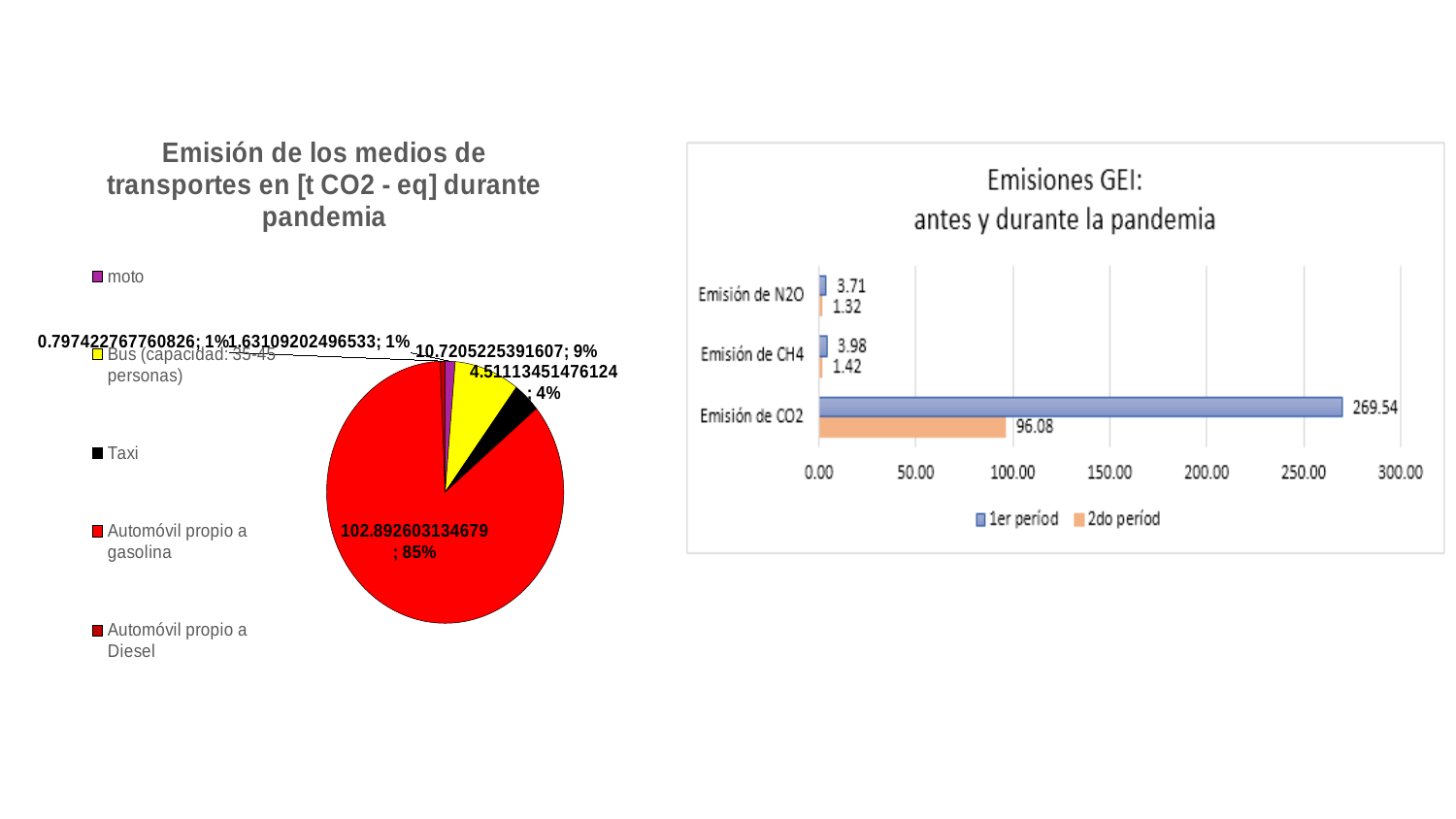
In the 'Emisiones GEI' chart, which category has the highest value for '1er período'? Emisión de CO2 In the 'Emisiones GEI' chart, what is the difference between the '1er período' and '2do período' values for 'Emisión de CO2'? 173.46 In the 'Emisiones GEI' chart, what is the value of 'Emisión de N2O' for '2do período'? 1.32 In the 'Emisiones GEI' chart, how many categories are shown on the vertical axis? 3 In the 'Emisiones GEI' chart, what is the value of 'Emisión de CH4' for '1er período'? 3.98 In the pie chart 'Emisión de los medios de transportes en [t CO2 - eq] durante pandemia', what is the value shown for 'Bus (capacidad: 35-45 personas)'? 10.7205225391607 In the 'Emisiones GEI' chart, what is the value of 'Emisión de CO2' for '2do período'? 96.08 In the pie chart 'Emisión de los medios de transportes en [t CO2 - eq] durante pandemia', how many entries does the legend list? 5 What kind of chart is the chart titled 'Emisiones GEI: antes y durante la pandemia'? bar chart In the 'Emisiones GEI' chart, how many series does the legend list? 2 In the pie chart 'Emisión de los medios de transportes en [t CO2 - eq] durante pandemia', what share does 'Automóvil propio a gasolina' have? 85% In the 'Emisiones GEI' chart, what is the value of 'Emisión de CO2' for '1er período'? 269.54